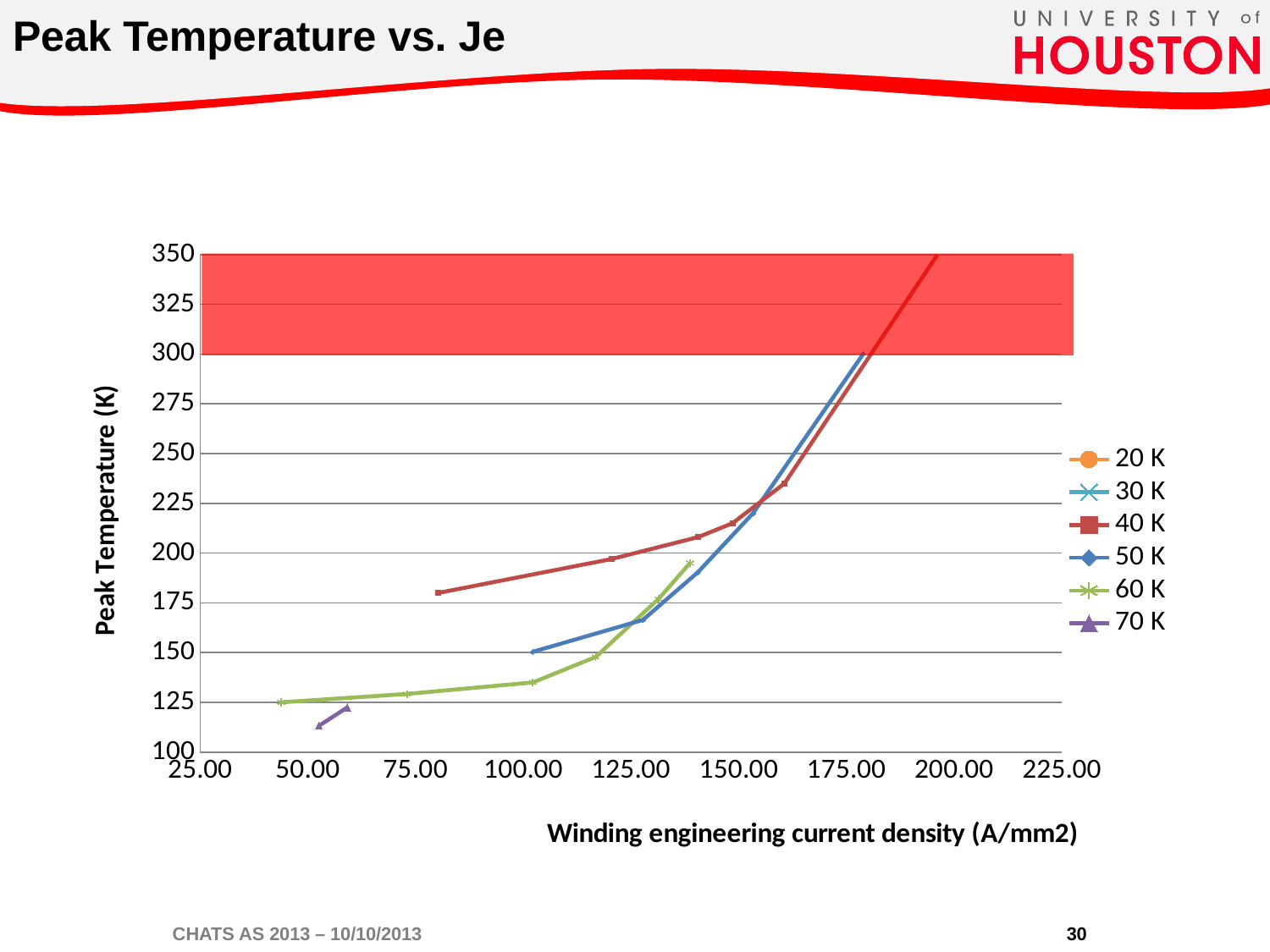
How many series does the legend list? 6 Is the highest point of the 60 K series greater or less than 200 K? less What is the label of the x axis? Winding engineering current density (A/mm2) Is the peak temperature of the 40 K series at its leftmost point (around 80 A/mm2) greater or less than 200 K? less Which plotted series has the lowest peak temperatures on the chart? 70 K Is the peak temperature of the 40 K series at around 160 A/mm2 greater or less than 225 K? greater Which plotted series reaches the highest peak temperature on the chart? 40 K At around 140 A/mm2, which series has the higher peak temperature, 40 K or 60 K? 40 K What is the title of the chart? Peak Temperature vs. Je What kind of chart is shown on the slide? line chart Does the peak temperature of the 40 K series rise or fall as the current density increases? rise